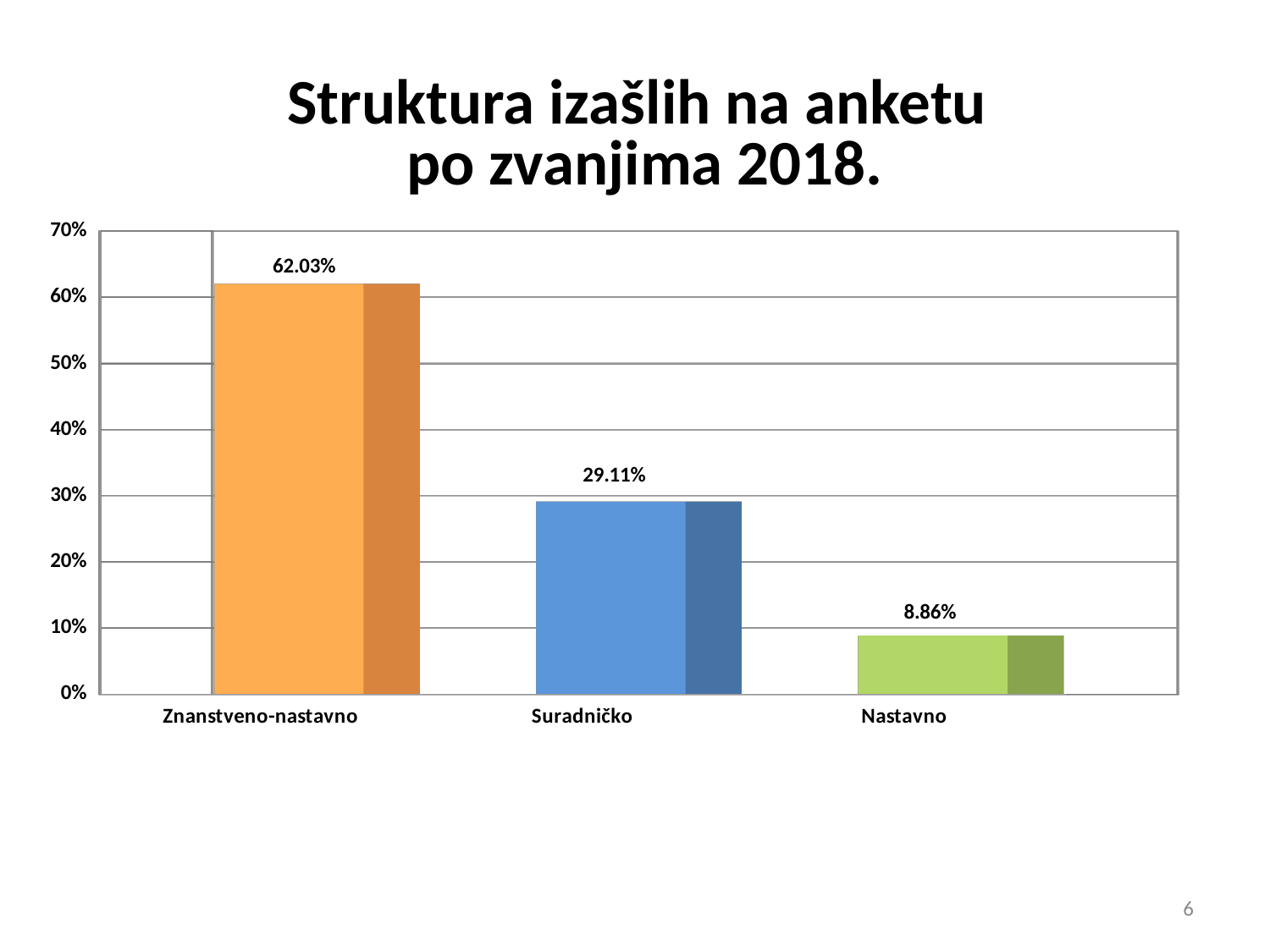
Which category has the lowest value? Nastavno What is the title of the chart on the slide? Struktura izašlih na anketu po zvanjima 2018. Which is larger, the value for Suradničko or the value for Nastavno? Suradničko What kind of chart is shown on the slide? bar chart What is the difference between the values for Suradničko and Nastavno? 20.25% What is the value for Suradničko? 29.11% What is the difference between the values for Znanstveno-nastavno and Suradničko? 32.92% What is the value for Znanstveno-nastavno? 62.03% Is the value for Suradničko greater or less than 30%? less What is the value for Nastavno? 8.86% Which category has the highest value? Znanstveno-nastavno How many categories are shown on the x axis? 3